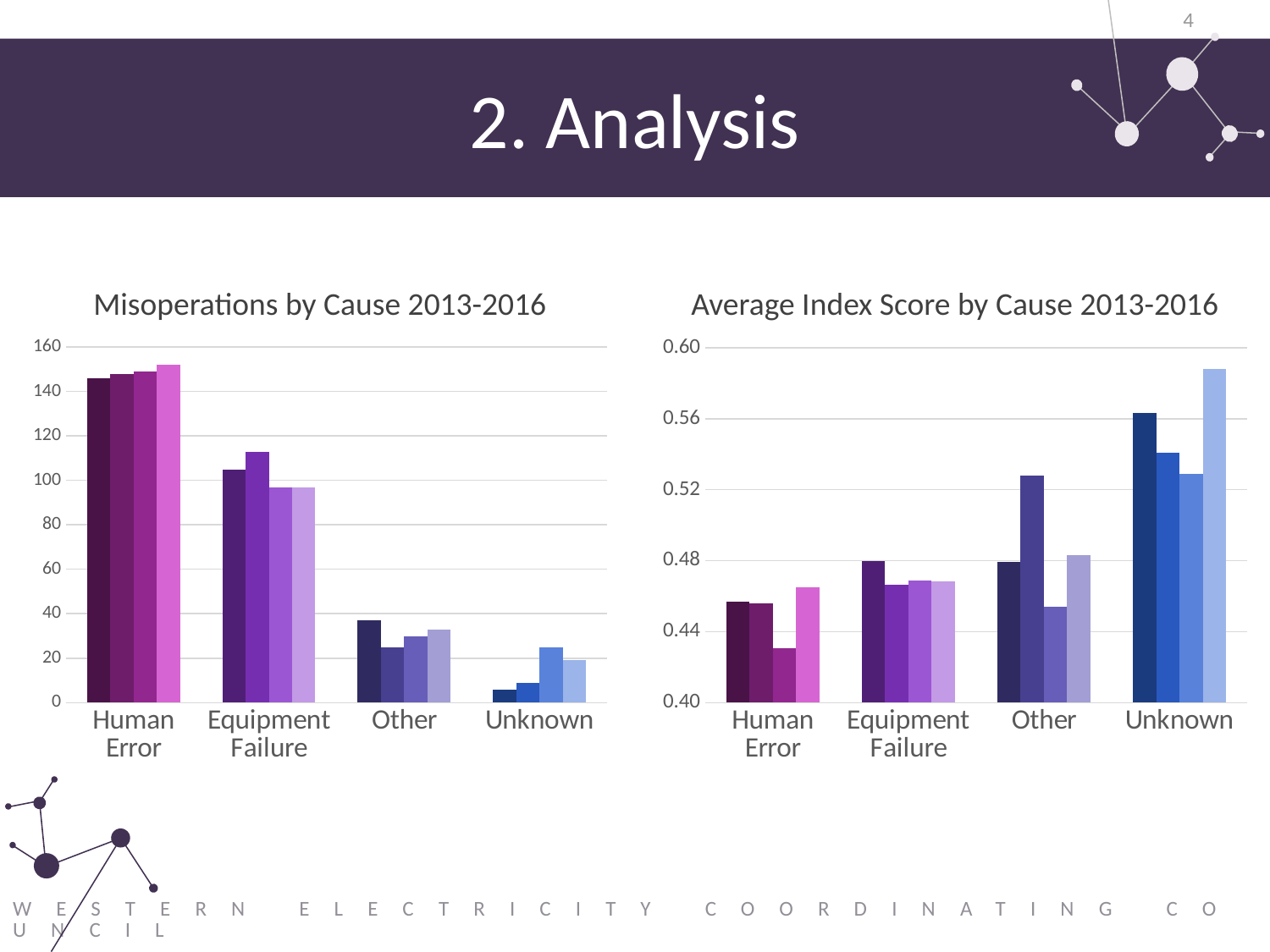
In the 'Average Index Score by Cause 2013-2016' chart, which category has the tallest bar? Unknown In the 'Average Index Score by Cause 2013-2016' chart, are all the Unknown bars greater or less than 0.52? greater How many categories are shown on the x axis of the 'Average Index Score by Cause 2013-2016' chart? 4 In the 'Misoperations by Cause 2013-2016' chart, are all the Human Error bars greater or less than 140? greater In the 'Average Index Score by Cause 2013-2016' chart, are all the Human Error bars greater or less than 0.48? less In the 'Misoperations by Cause 2013-2016' chart, which category has the highest bars? Human Error In the 'Misoperations by Cause 2013-2016' chart, which category has the lowest bars? Unknown In the 'Misoperations by Cause 2013-2016' chart, which category has higher bars, Equipment Failure or Other? Equipment Failure What kind of chart is the 'Misoperations by Cause 2013-2016' chart? bar chart How many bars are plotted for each category in the 'Misoperations by Cause 2013-2016' chart? 4 What is the title of the chart on the right side of the slide? Average Index Score by Cause 2013-2016